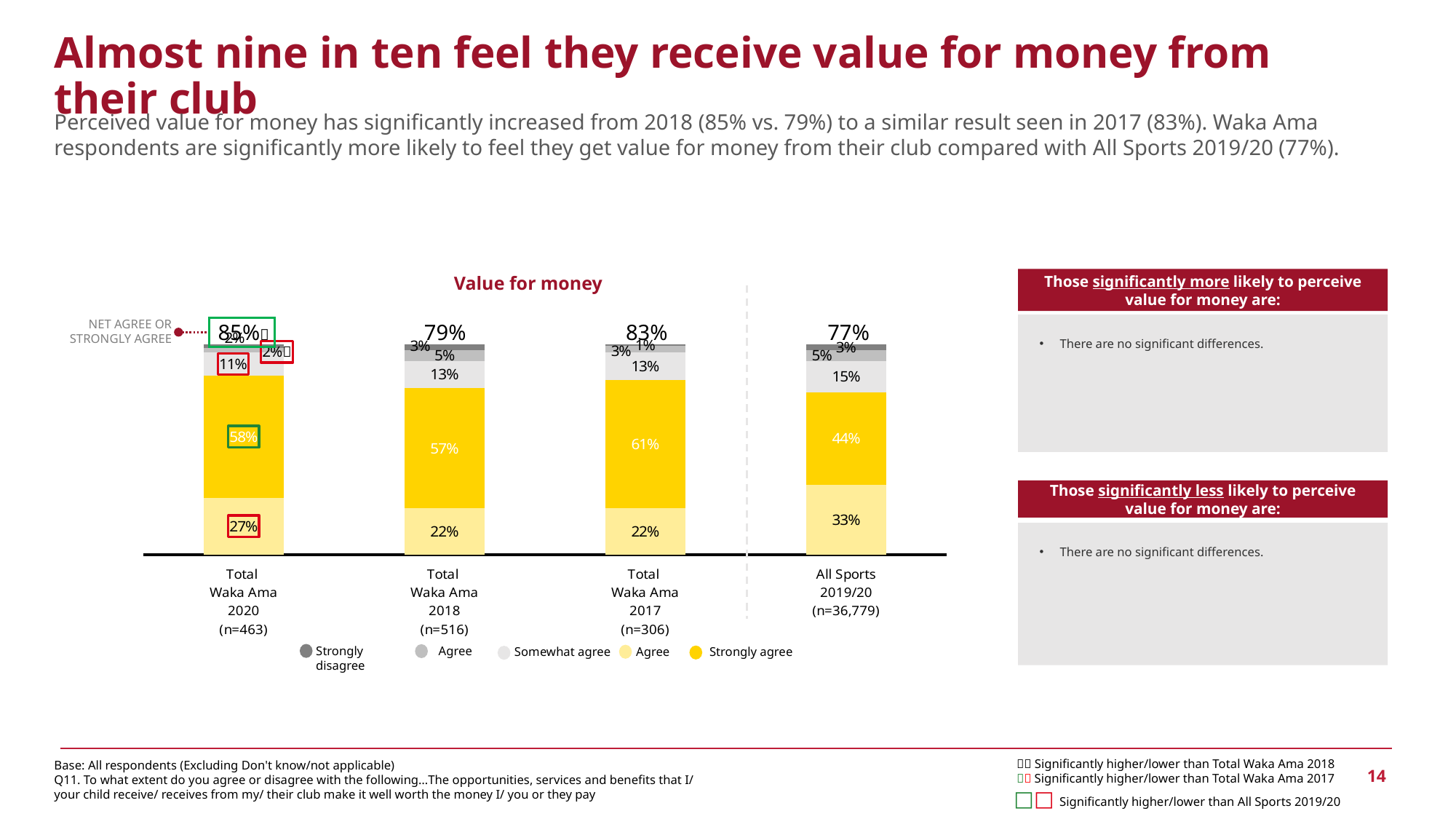
How many bars (groups) are plotted in the chart? 4 What is the net agree or strongly agree value for Total Waka Ama 2020? 85% What is the Strongly agree value for All Sports 2019/20? 44% What is the Strongly agree value for Total Waka Ama 2017? 61% Which group has the lowest Strongly agree value? All Sports 2019/20 What is the net agree or strongly agree value for All Sports 2019/20? 77% What is the difference between the net agree values for Total Waka Ama 2020 and Total Waka Ama 2018? 6 percentage points What type of chart is shown on the slide? Stacked bar chart What is the title of the chart? Value for money What is the Somewhat agree value for Total Waka Ama 2018? 13% How many series does the legend list? 5 Which group has the highest net agree or strongly agree value? Total Waka Ama 2020